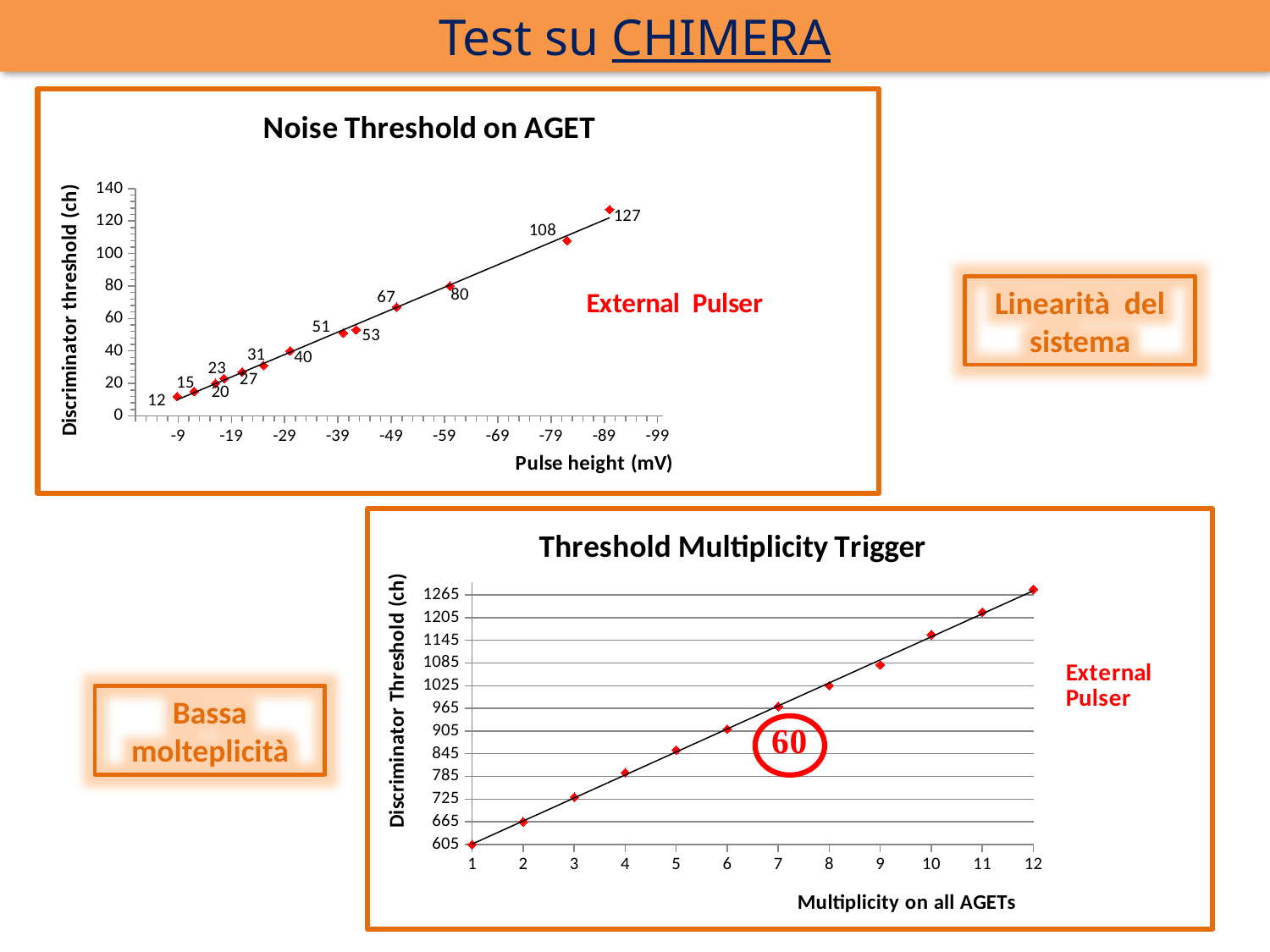
In the 'Noise Threshold on AGET' chart, does the discriminator threshold rise or fall as the pulse height moves from -9 toward -99 mV? rise In the 'Threshold Multiplicity Trigger' chart, what is the discriminator threshold at multiplicity 1? 605 In the 'Noise Threshold on AGET' chart, what is the highest labelled discriminator threshold value? 127 What is the x-axis label of the 'Noise Threshold on AGET' chart? Pulse height (mV) In the 'Noise Threshold on AGET' chart, what is the lowest labelled discriminator threshold value? 12 In the 'Noise Threshold on AGET' chart, how many data points are plotted? 13 In the 'Threshold Multiplicity Trigger' chart, is the discriminator threshold at multiplicity 7 greater or less than 905? greater In the 'Threshold Multiplicity Trigger' chart, how many multiplicity points are plotted? 12 In the 'Noise Threshold on AGET' chart, what is the difference between the highest labelled value (127) and the second highest (108)? 19 In the 'Threshold Multiplicity Trigger' chart, which multiplicity has the highest discriminator threshold? 12 What is the title of the top chart? Noise Threshold on AGET In the 'Threshold Multiplicity Trigger' chart, is the discriminator threshold at multiplicity 3 greater or less than 845? less